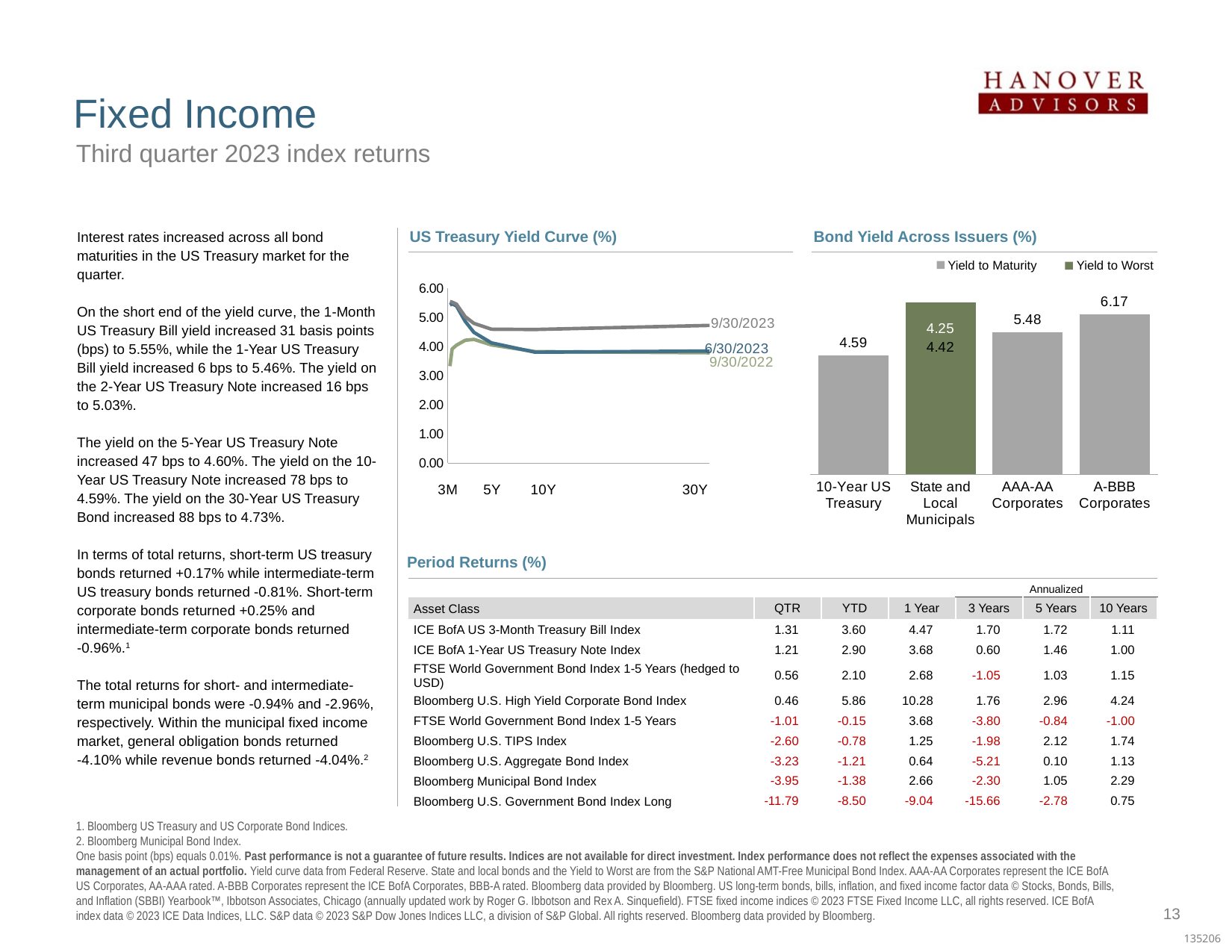
What kind of chart is the US Treasury Yield Curve (%) chart? Line chart In the Bond Yield Across Issuers (%) chart, what is the value shown for A-BBB Corporates? 6.17 In the US Treasury Yield Curve (%) chart, which dated line is highest at the 30Y point? 9/30/2023 How many categories are shown on the x axis of the Bond Yield Across Issuers (%) chart? 4 What kind of chart is the Bond Yield Across Issuers (%) chart? Bar chart In the Bond Yield Across Issuers (%) chart, what is the difference between the values for A-BBB Corporates and AAA-AA Corporates? 0.69 In the Bond Yield Across Issuers (%) chart, what is the value shown for AAA-AA Corporates? 5.48 In the Bond Yield Across Issuers (%) chart, what is the difference between the values for A-BBB Corporates and 10-Year US Treasury? 1.58 In the Bond Yield Across Issuers (%) chart, which is larger: the value for AAA-AA Corporates or the value for 10-Year US Treasury? AAA-AA Corporates In the Bond Yield Across Issuers (%) chart, what is the value shown for 10-Year US Treasury? 4.59 In the US Treasury Yield Curve (%) chart, is the 9/30/2023 line at 30Y greater or less than 4.00? greater How many series does the legend of the Bond Yield Across Issuers (%) chart list? 2